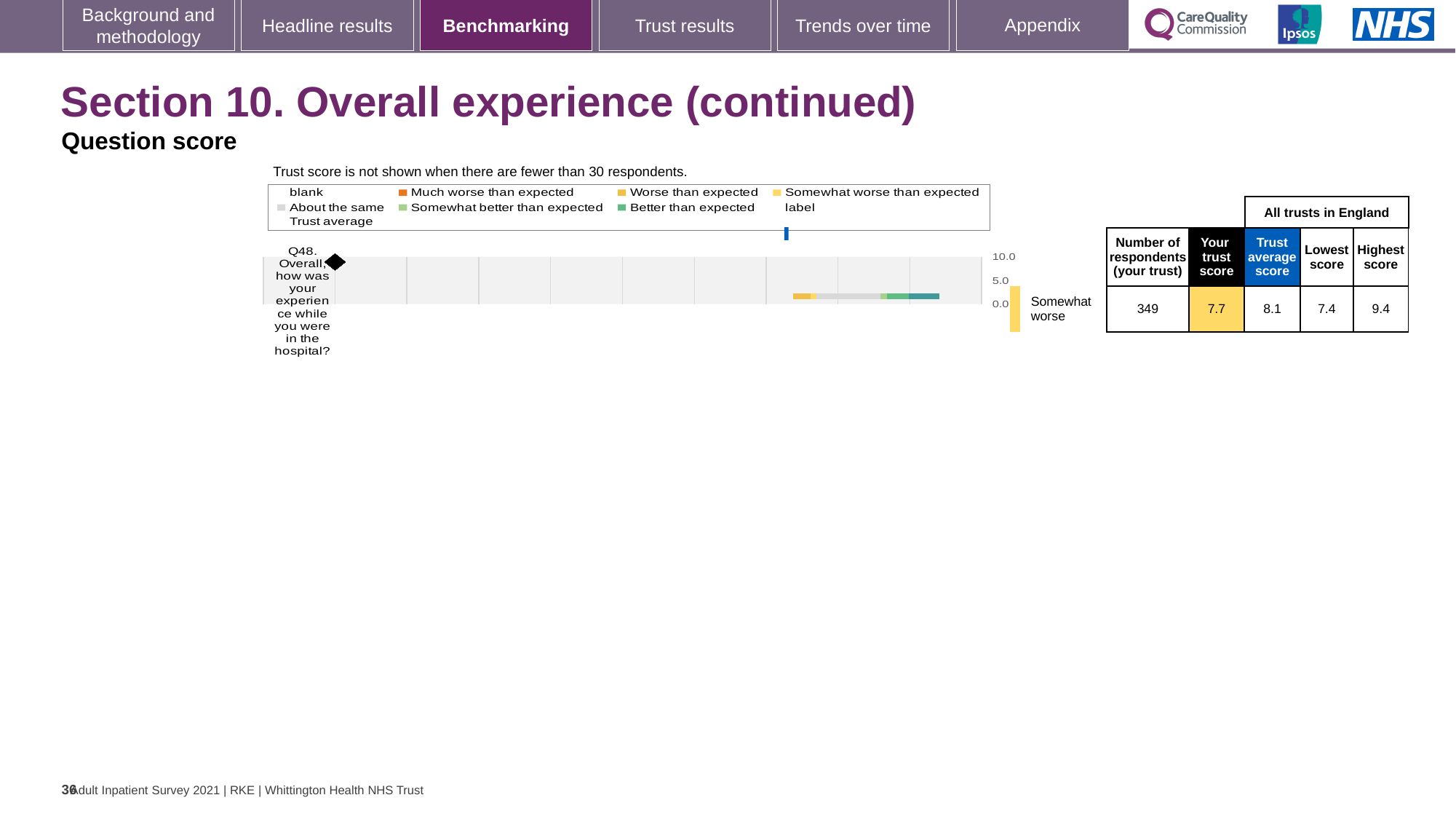
Which question is plotted in the benchmarking chart? Q48. Overall, how was your experience while you were in the hospital? What is the highest value shown on the chart's score axis? 10.0 What is the difference between the highest score and the lowest score for Q48? 2.0 What is the highest score for Q48 across all trusts in England? 9.4 How many questions are plotted in the benchmarking chart? 1 What benchmark category label is shown next to the Q48 bar? Somewhat worse Which is larger for Q48: the trust's score or the trust average score? Trust average score What is the trust average score for Q48 across all trusts in England? 8.1 How many respondents from the trust answered Q48? 349 What is the trust's score for Q48? 7.7 What kind of chart is used to show the Q48 benchmarking result? Bar chart What is the lowest score for Q48 across all trusts in England? 7.4